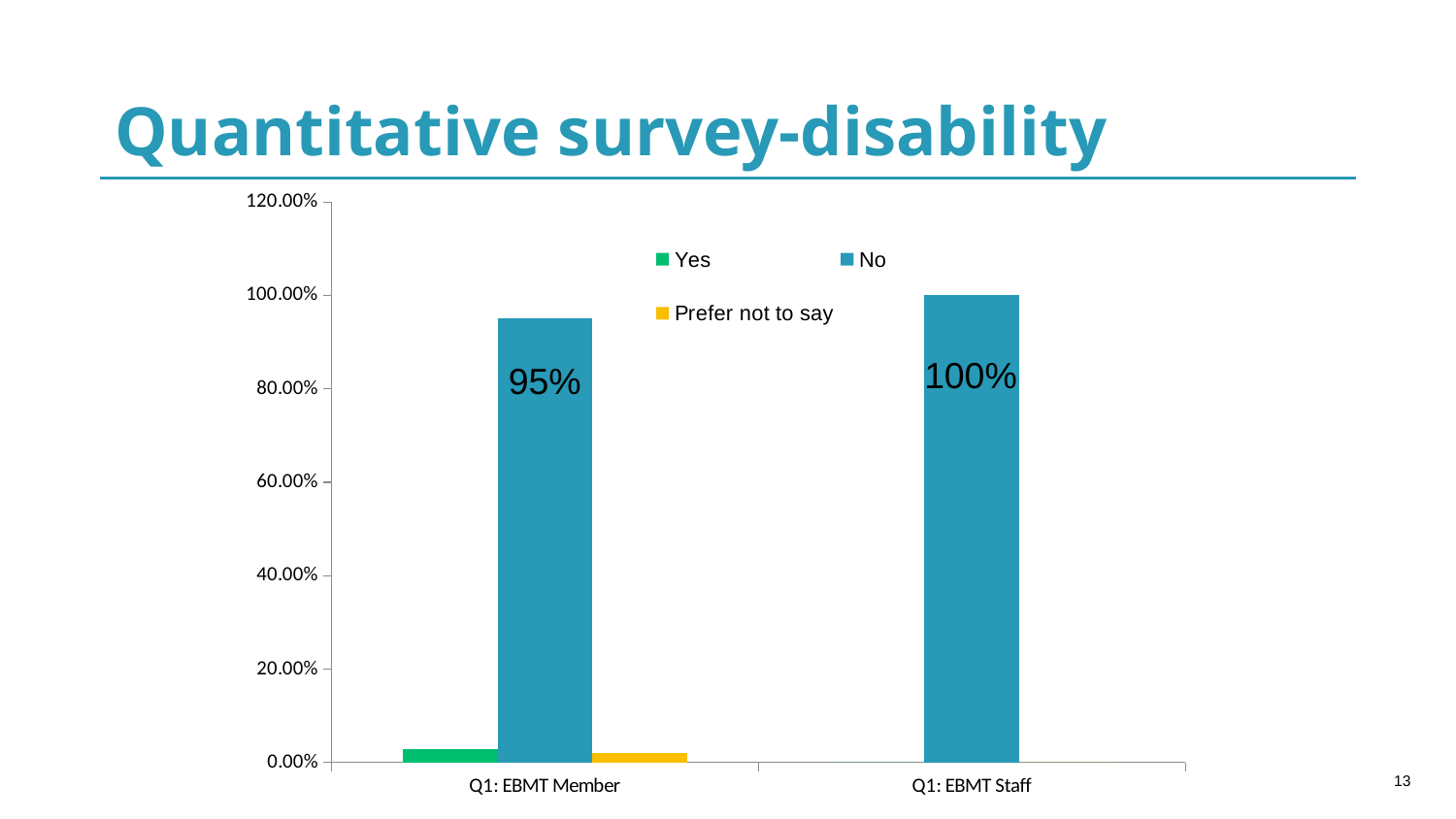
Which series has the highest value for Q1: EBMT Member? No What is the difference between the No values for Q1: EBMT Staff and Q1: EBMT Member? 5% How many categories are shown on the x axis? 2 Which category has the larger No value, Q1: EBMT Member or Q1: EBMT Staff? Q1: EBMT Staff How many series does the legend list? 3 What is the value of the No series for Q1: EBMT Member? 95% What is the title of the slide? Quantitative survey-disability Is the value of the Yes series for Q1: EBMT Member greater or less than 20.00%? less Is the value of the Prefer not to say series for Q1: EBMT Member greater or less than 20.00%? less What is the value of the No series for Q1: EBMT Staff? 100% What are the three entries in the chart legend? Yes, No, Prefer not to say What kind of chart is shown on the slide? bar chart